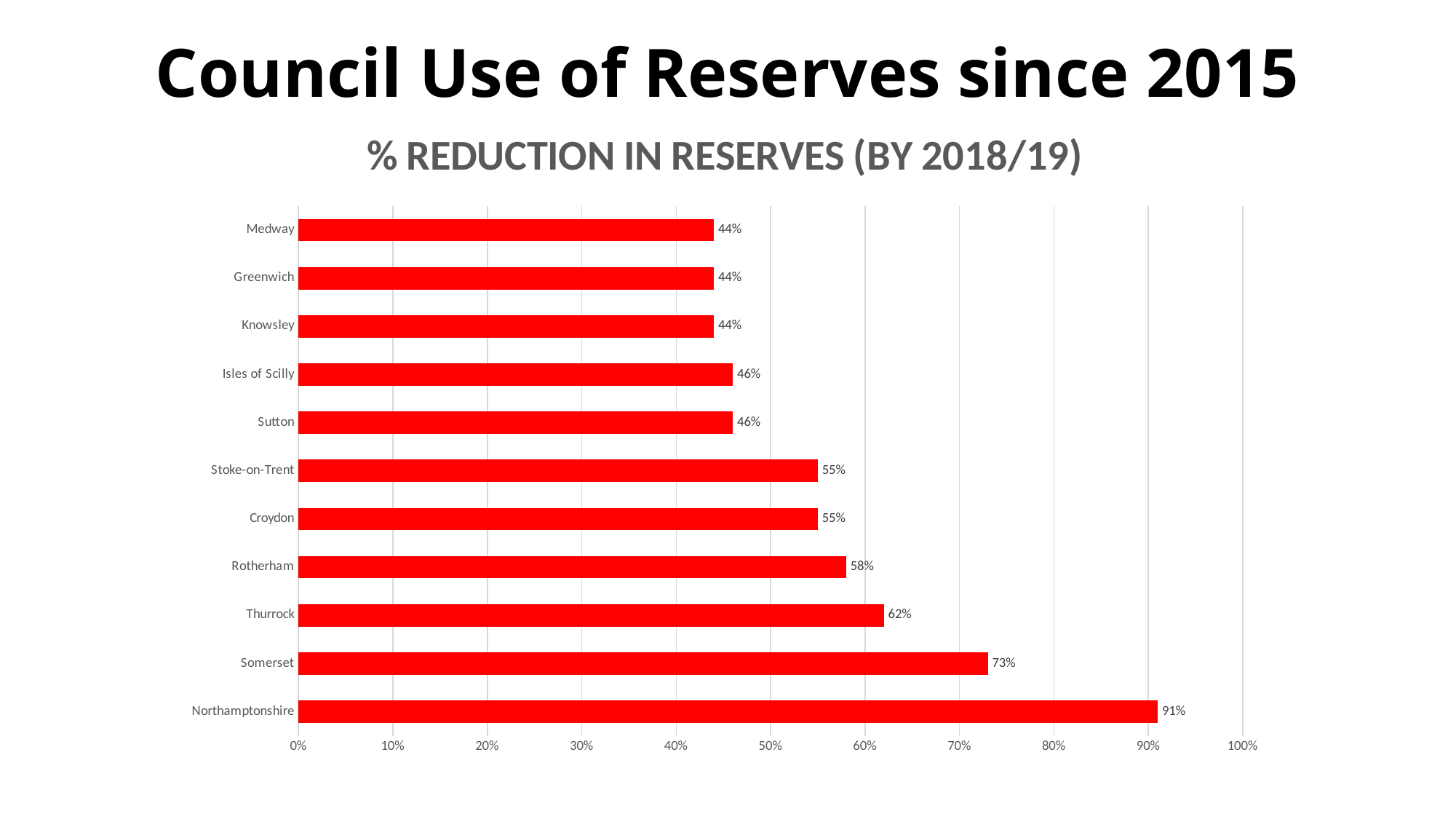
What is the % reduction in reserves for Northamptonshire? 91% Which has a larger % reduction in reserves, Stoke-on-Trent or Medway? Stoke-on-Trent What is the difference between the % reduction in reserves for Northamptonshire and Somerset? 18% What kind of chart is shown on the slide? Bar chart What is the % reduction in reserves for Somerset? 73% How many councils are shown in the chart? 11 What is the difference between the % reduction in reserves for Thurrock and Croydon? 7% What is the title of the chart? % REDUCTION IN RESERVES (BY 2018/19) Is the value for Thurrock greater or less than 50%? greater What is the % reduction in reserves for Sutton? 46% What is the % reduction in reserves for Rotherham? 58% Which council has the highest % reduction in reserves? Northamptonshire